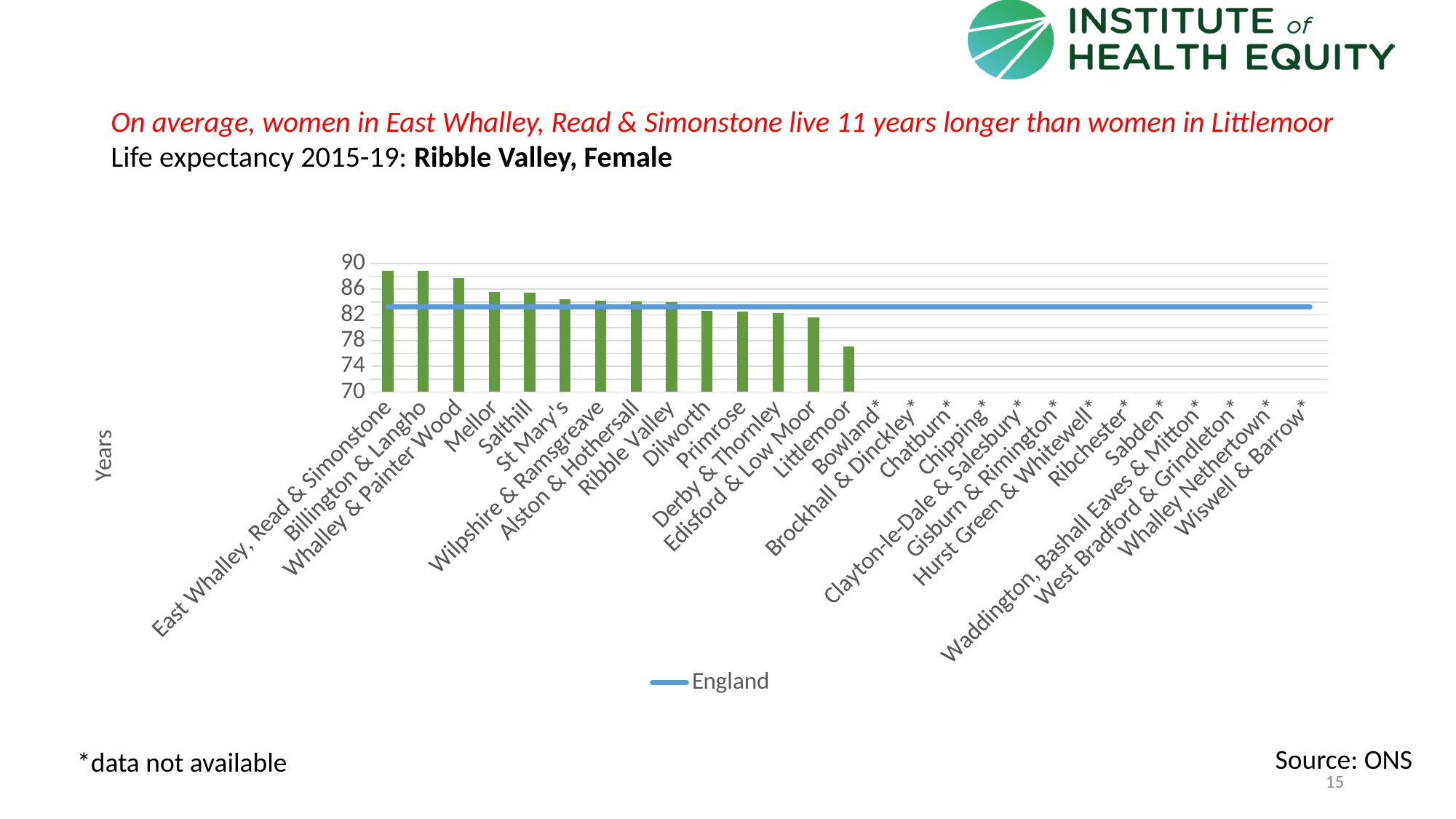
How many areas on the x axis are marked with an asterisk as data not available? 13 Which area has the lowest female life expectancy among the bars shown? Littlemoor Is the value for Whalley & Painter Wood greater or less than 86? greater Which is larger, the value for Mellor or the value for Littlemoor? Mellor How many areas have a bar plotted on the chart? 14 What series does the legend list? England Which is larger, the value for Whalley & Painter Wood or the value for Salthill? Whalley & Painter Wood Is the value for Edisford & Low Moor greater or less than 82? less What kind of chart is shown on the slide? bar chart Is the value for Littlemoor greater or less than 78? less Do the bar values rise or fall from left to right along the x axis? fall